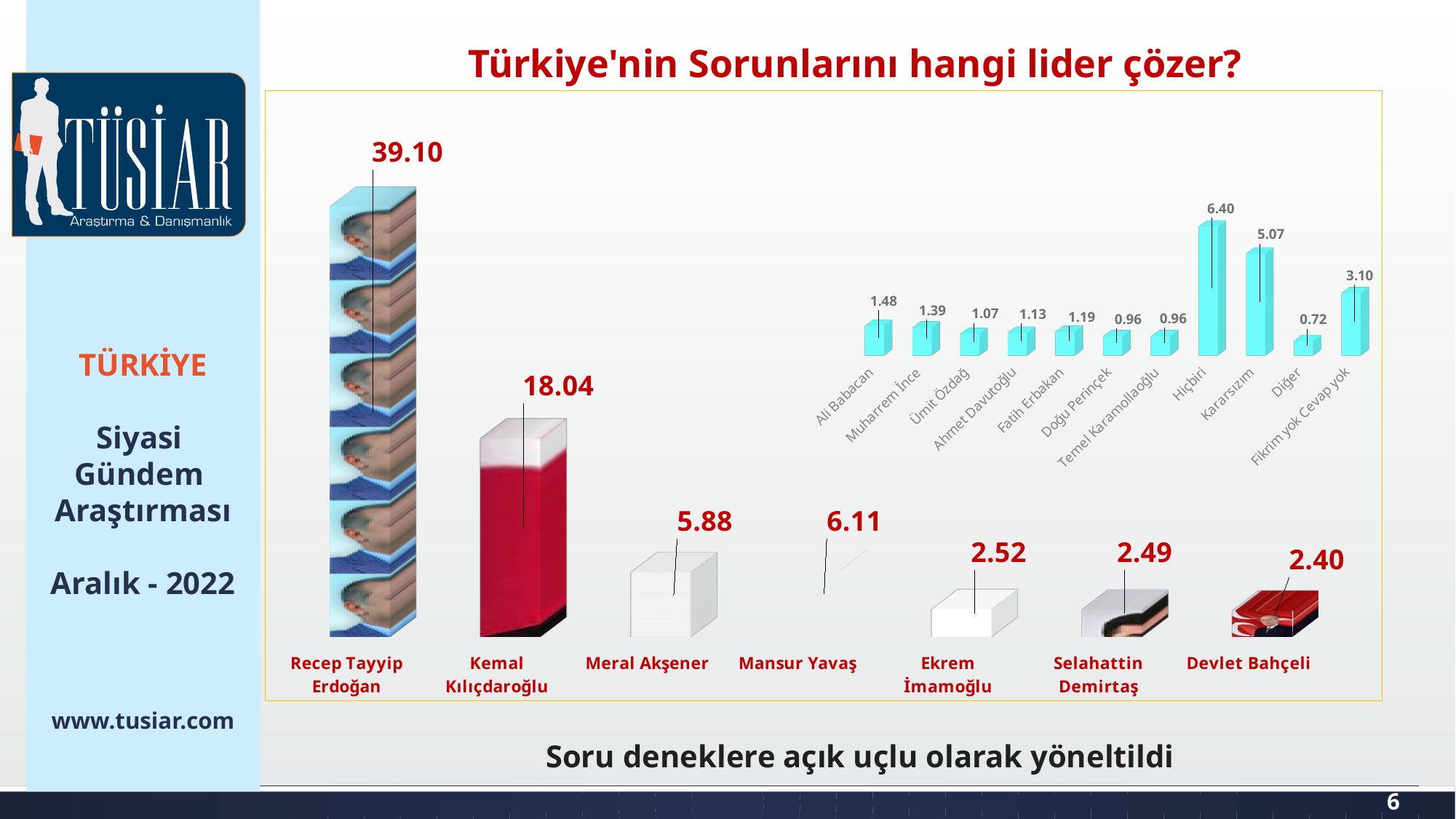
In the main chart, which leader has the highest value? Recep Tayyip Erdoğan In the main chart, which is larger: the value for Mansur Yavaş or the value for Meral Akşener? Mansur Yavaş In the main chart, what is the value for Recep Tayyip Erdoğan? 39.10 How many leaders are shown in the main chart? 7 In the smaller chart at the upper right, what is the value for Ali Babacan? 1.48 What is the title of the chart on the slide? Türkiye'nin Sorunlarını hangi lider çözer? In the smaller chart at the upper right, which category has the lowest value? Diğer In the main chart, which leader has the lowest value? Devlet Bahçeli In the main chart, what is the difference between the values for Recep Tayyip Erdoğan and Kemal Kılıçdaroğlu? 21.06 In the smaller chart at the upper right, what is the value for Hiçbiri? 6.40 In the main chart, what is the value for Kemal Kılıçdaroğlu? 18.04 How many categories are shown in the smaller chart at the upper right? 11